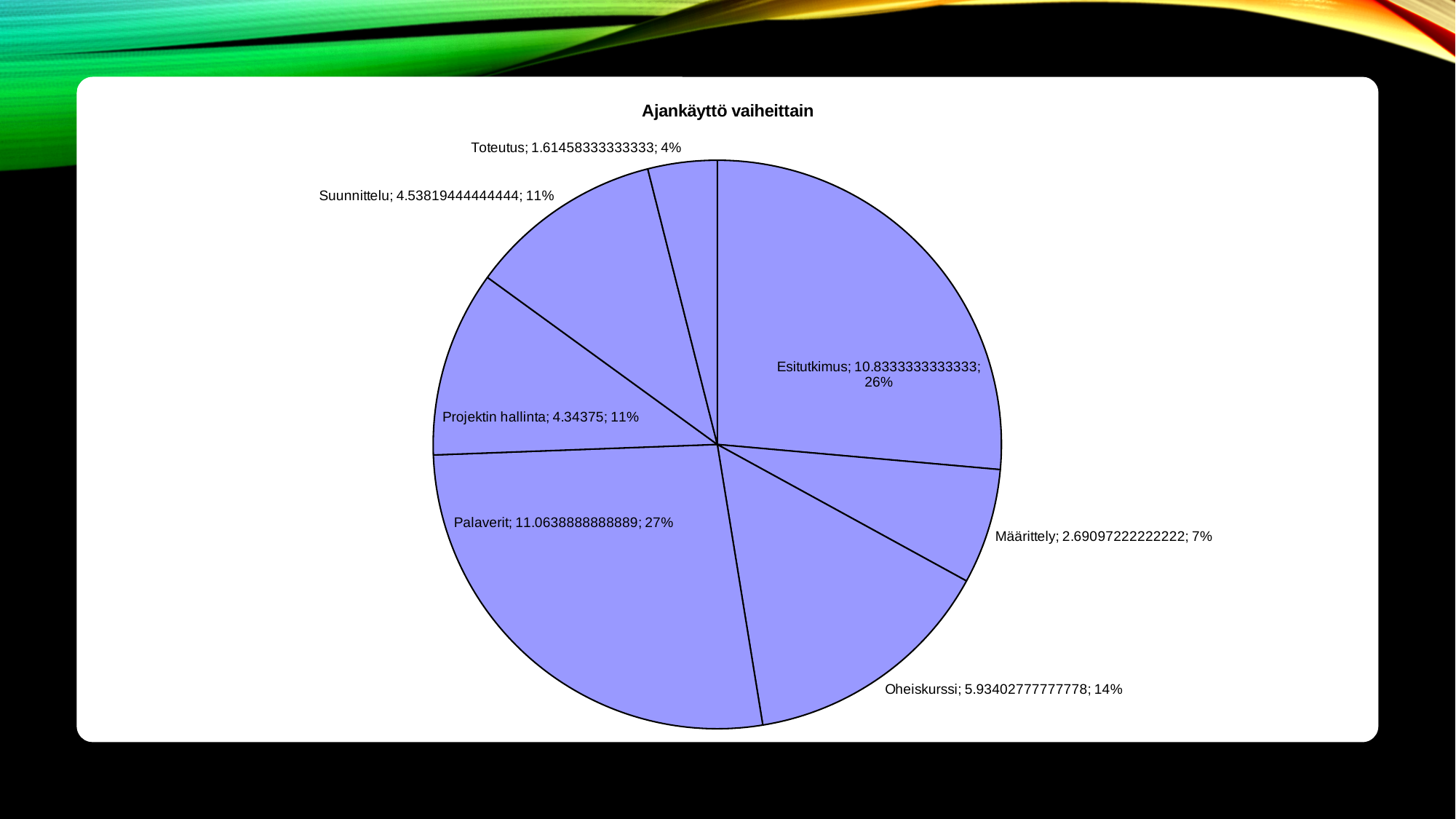
What share of the pie does Palaverit represent? 27% What percentage is shown for Määrittely? 7% Which has a larger share, Oheiskurssi or Suunnittelu? Oheiskurssi What value is shown for Projektin hallinta? 4.34375 What value is shown for Oheiskurssi? 5.93402777777778 What is the difference in percentage points between the shares of Oheiskurssi and Määrittely? 7 percentage points How many slices does the pie chart have? 7 What type of chart is shown on the slide? pie chart What share of the pie does Esitutkimus represent? 26% Which category has the smallest share of the pie? Toteutus Which category has the largest share of the pie? Palaverit What is the title of the chart? Ajankäyttö vaiheittain